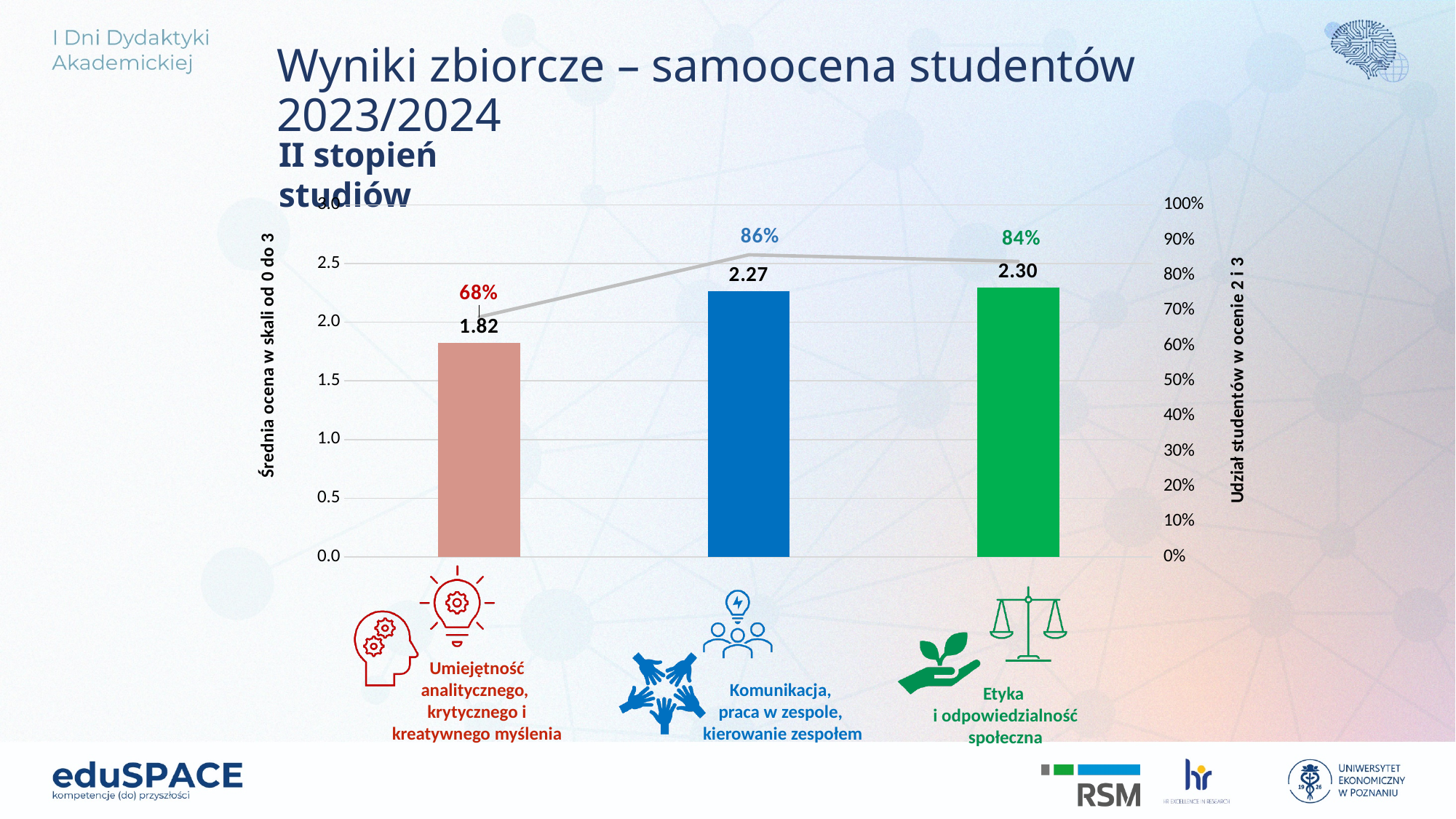
Which category has the lowest average score? Umiejętność analitycznego, krytycznego i kreatywnego myślenia What is the average score (Średnia ocena) for Umiejętność analitycznego, krytycznego i kreatywnego myślenia? 1.82 What is the difference in student share between Komunikacja, praca w zespole, kierowanie zespołem and Umiejętność analitycznego, krytycznego i kreatywnego myślenia? 18% What is the average score (Średnia ocena) for Komunikacja, praca w zespole, kierowanie zespołem? 2.27 What percentage of students (Udział studentów w ocenie 2 i 3) is shown for Umiejętność analitycznego, krytycznego i kreatywnego myślenia? 68% What is the label of the left vertical axis? Średnia ocena w skali od 0 do 3 Which category has the highest share of students rating 2 or 3? Komunikacja, praca w zespole, kierowanie zespołem What is the difference in average score between Etyka i odpowiedzialność społeczna and Umiejętność analitycznego, krytycznego i kreatywnego myślenia? 0.48 How many categories are shown in the chart? 3 What percentage of students (Udział studentów w ocenie 2 i 3) is shown for Etyka i odpowiedzialność społeczna? 84% Which category has the highest average score? Etyka i odpowiedzialność społeczna Which has a higher average score: Komunikacja, praca w zespole, kierowanie zespołem or Umiejętność analitycznego, krytycznego i kreatywnego myślenia? Komunikacja, praca w zespole, kierowanie zespołem